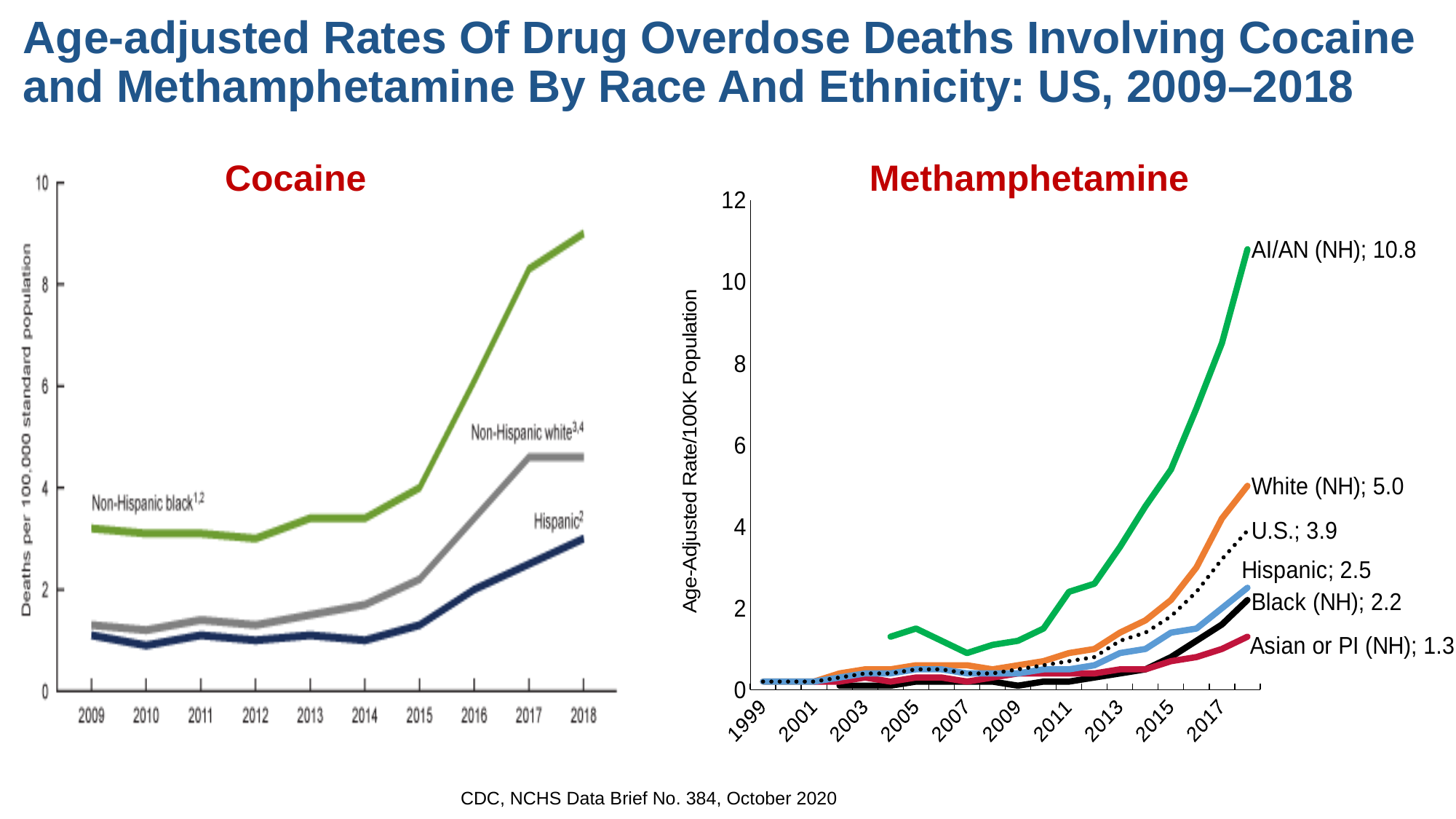
On the Methamphetamine chart, which has the larger final value, Hispanic or Black (NH)? Hispanic On the Methamphetamine chart, which group has the highest final value? AI/AN (NH) On the Methamphetamine chart, which group has the lowest final value? Asian or PI (NH) On the Methamphetamine chart, what is the final value shown for AI/AN (NH)? 10.8 On the Methamphetamine chart, what is the final value shown for White (NH)? 5.0 On the Methamphetamine chart, how many series are labelled? 6 On the Methamphetamine chart, what is the final value shown for Asian or PI (NH)? 1.3 On the Cocaine chart, is the 2018 value for Non-Hispanic black greater or less than 8? greater On the Cocaine chart, is the 2018 value for Hispanic greater or less than 4? less What kind of chart is the Cocaine chart? Line chart On the Cocaine chart, how many series are plotted? 3 On the Methamphetamine chart, what is the difference between the final values for AI/AN (NH) and White (NH)? 5.8